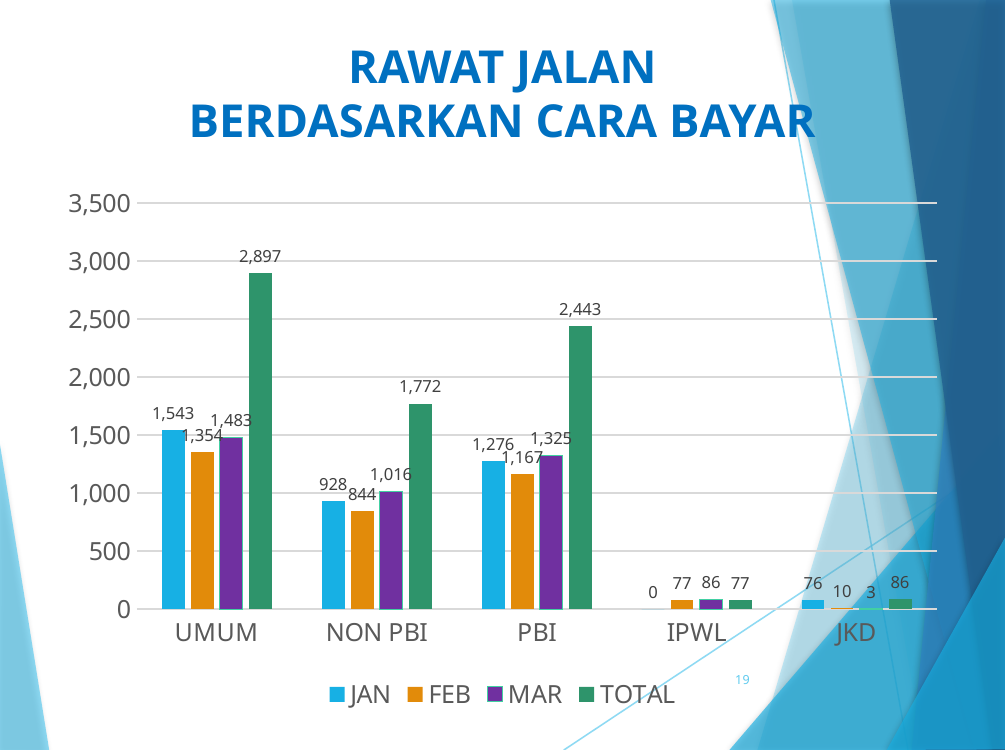
What kind of chart is shown on the slide? bar chart How many series does the legend list? 4 Which category has the highest TOTAL value? UMUM Is the JAN value for NON PBI greater or less than 1,000? less What is the FEB value for JKD? 10 What is the difference between the TOTAL values for UMUM and PBI? 454 What is the TOTAL value for PBI? 2,443 Which category has the lowest JAN value? IPWL What is the JAN value for UMUM? 1,543 What is the MAR value for NON PBI? 1,016 How many categories are shown on the x axis? 5 Which is larger, the MAR value for UMUM or the MAR value for PBI? UMUM